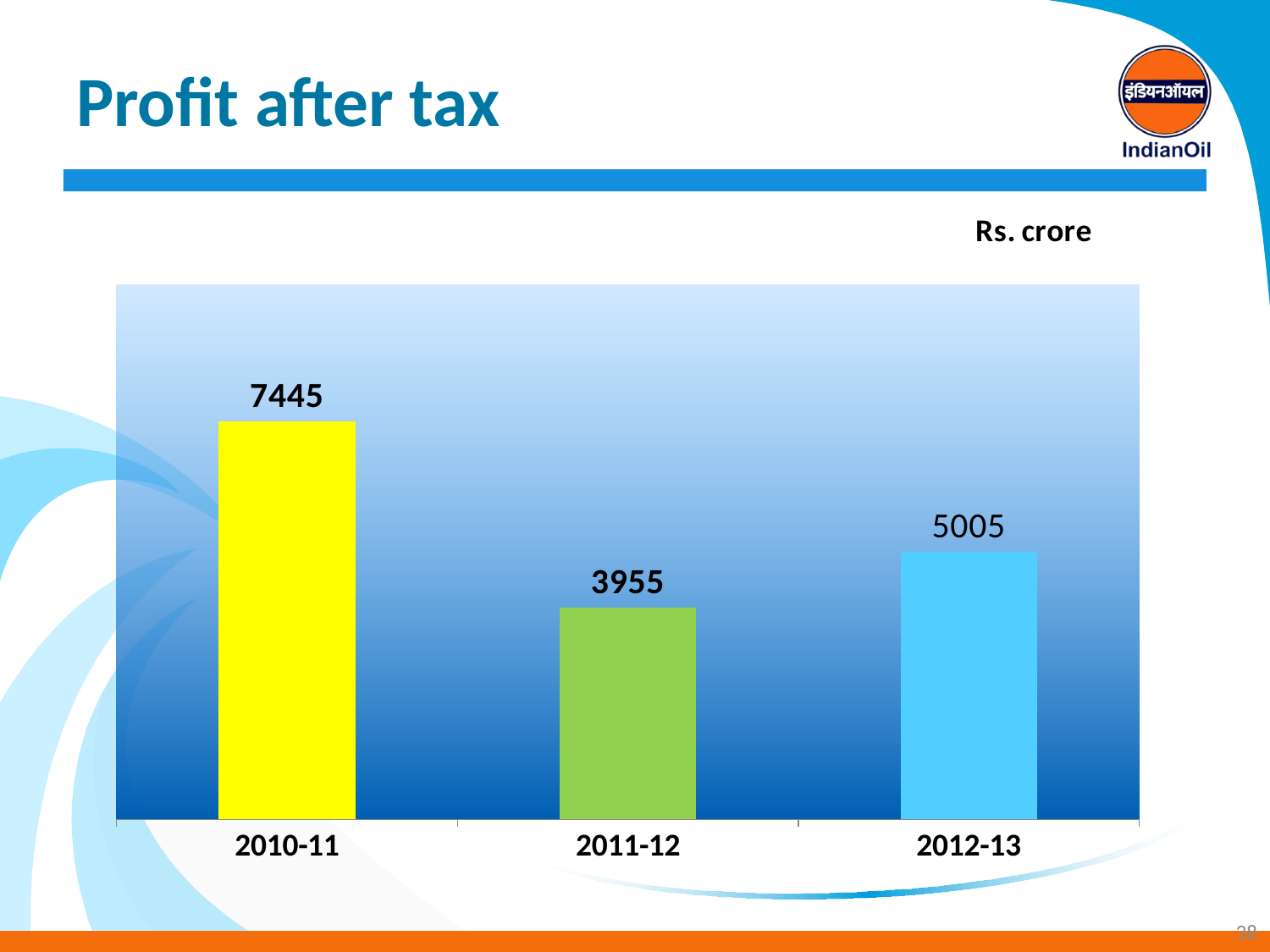
Which year has a larger profit after tax, 2011-12 or 2012-13? 2012-13 What is the difference in profit after tax between 2010-11 and 2011-12? 3490 What is the profit after tax for 2011-12? 3955 What is the profit after tax for 2010-11? 7445 What kind of chart is shown on the slide? Bar chart Which year has the lowest profit after tax? 2011-12 What unit is the profit after tax expressed in? Rs. crore What colour is the bar for 2010-11? Yellow What is the profit after tax for 2012-13? 5005 What is the difference in profit after tax between 2012-13 and 2011-12? 1050 Which year has the highest profit after tax? 2010-11 How many years are shown in the chart? 3